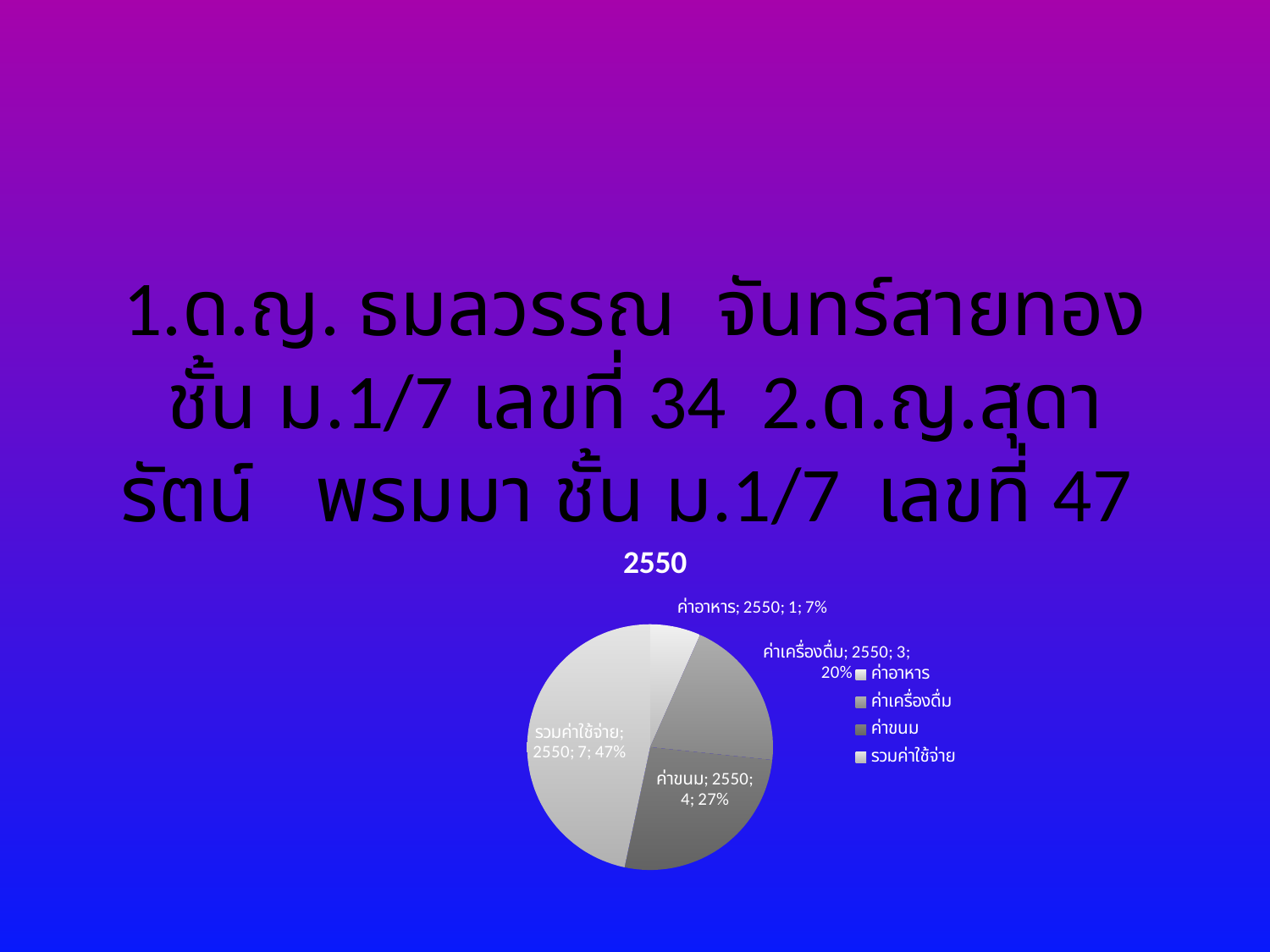
What is the difference between the values for ค่าขนม and ค่าเครื่องดื่ม? 1 What is the value for ค่าเครื่องดื่ม in the pie chart? 3 Which slice of the pie chart is the largest? รวมค่าใช้จ่าย What share of the pie does รวมค่าใช้จ่าย take? 47% What share of the pie does ค่าขนม take? 27% How many slices does the pie chart have? 4 What is the title of the chart? 2550 What kind of chart is shown on the slide? pie chart How many entries does the chart legend list? 4 What is the value for ค่าขนม in the pie chart? 4 What is the value for ค่าอาหาร in the pie chart? 1 Which slice of the pie chart is the smallest? ค่าอาหาร